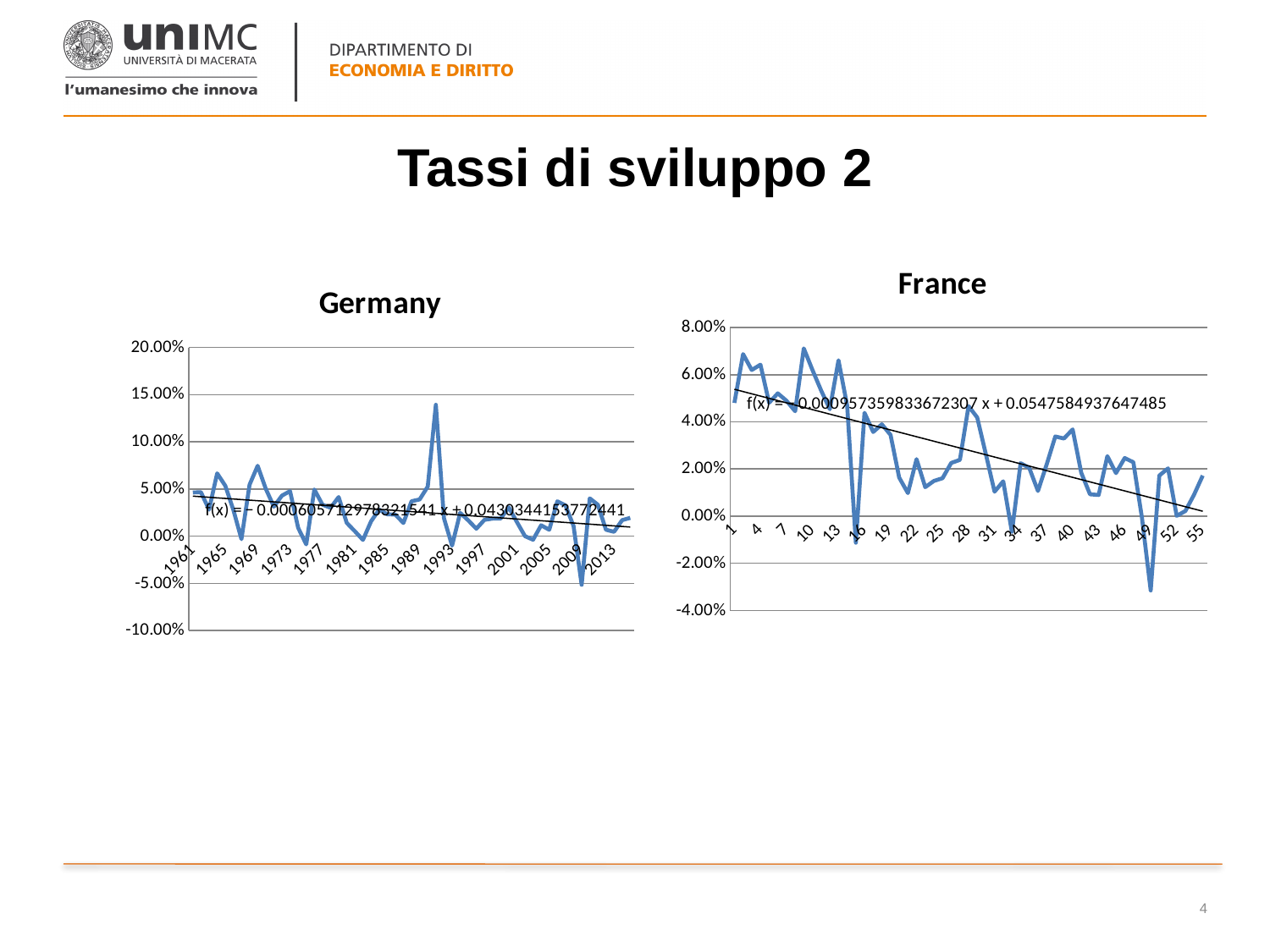
On the France chart, is the highest value of the series greater or less than 6.00%? greater On the Germany chart, is the highest value of the series greater or less than 10.00%? greater On the Germany chart, does the fitted trendline rise or fall along the x axis? fall On the Germany chart, is the lowest value of the series greater or less than 0.00%? less What kind of chart is the Germany chart? line chart Which chart reaches a higher peak value, Germany or France? Germany On the France chart, what is the intercept (constant term) shown in the trendline equation f(x)? 0.0547584937647485 What kind of chart is the France chart? line chart What is the title of the chart on the right of the slide? France On the France chart, does the fitted trendline rise or fall along the x axis? fall What is the title of the chart on the left of the slide? Germany